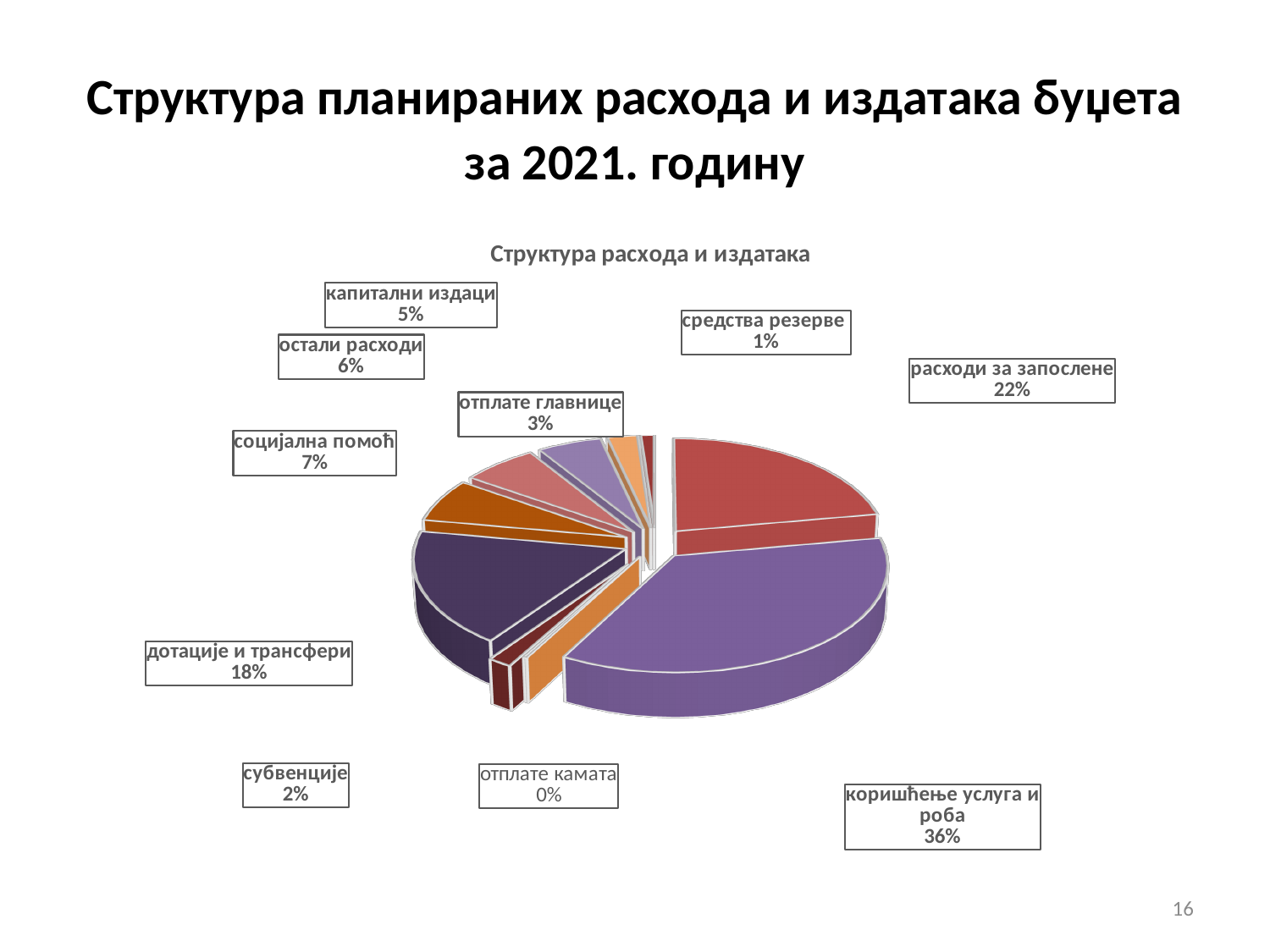
What share of the pie does "расходи за запослене" have? 22% How many categories are shown in the pie chart? 10 Which is larger, the share for "остали расходи" or the share for "капитални издаци"? остали расходи What is the difference between the shares of "коришћење услуга и роба" and "расходи за запослене"? 14% What is the value shown for "социјална помоћ"? 7% What is the value shown for "дотације и трансфери"? 18% Which category has the smallest share of the pie? отплате камата What is the title of the chart? Структура расхода и издатака Which category has the largest share of the pie? коришћење услуга и роба What share of the pie does "коришћење услуга и роба" have? 36% What kind of chart is shown on the slide? pie chart What is the value shown for "отплате камата"? 0%